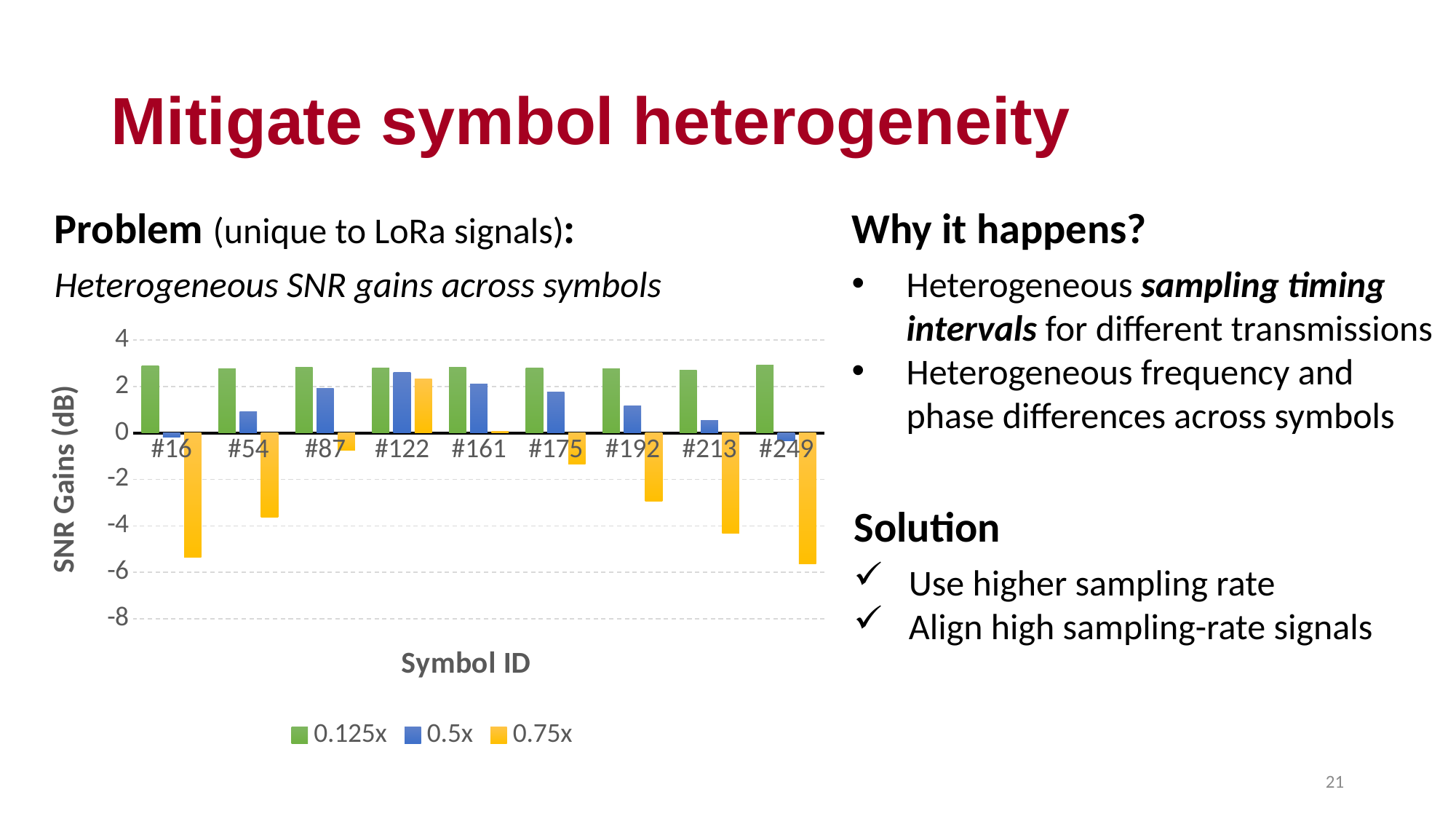
Is the 0.75x value for symbol #16 greater or less than -4? less How many symbol IDs are shown on the x axis of the chart? 9 Is the 0.5x value for symbol #122 greater or less than 2? greater What kind of chart is shown on the slide? bar chart What is the x-axis title of the chart? Symbol ID Is the 0.75x value for symbol #192 greater or less than -2? less What is the y-axis title of the chart? SNR Gains (dB) For the 0.5x series, which symbol ID has the highest SNR gain? #122 How many series does the chart legend list? 3 For the 0.75x series, which symbol ID has the highest SNR gain? #122